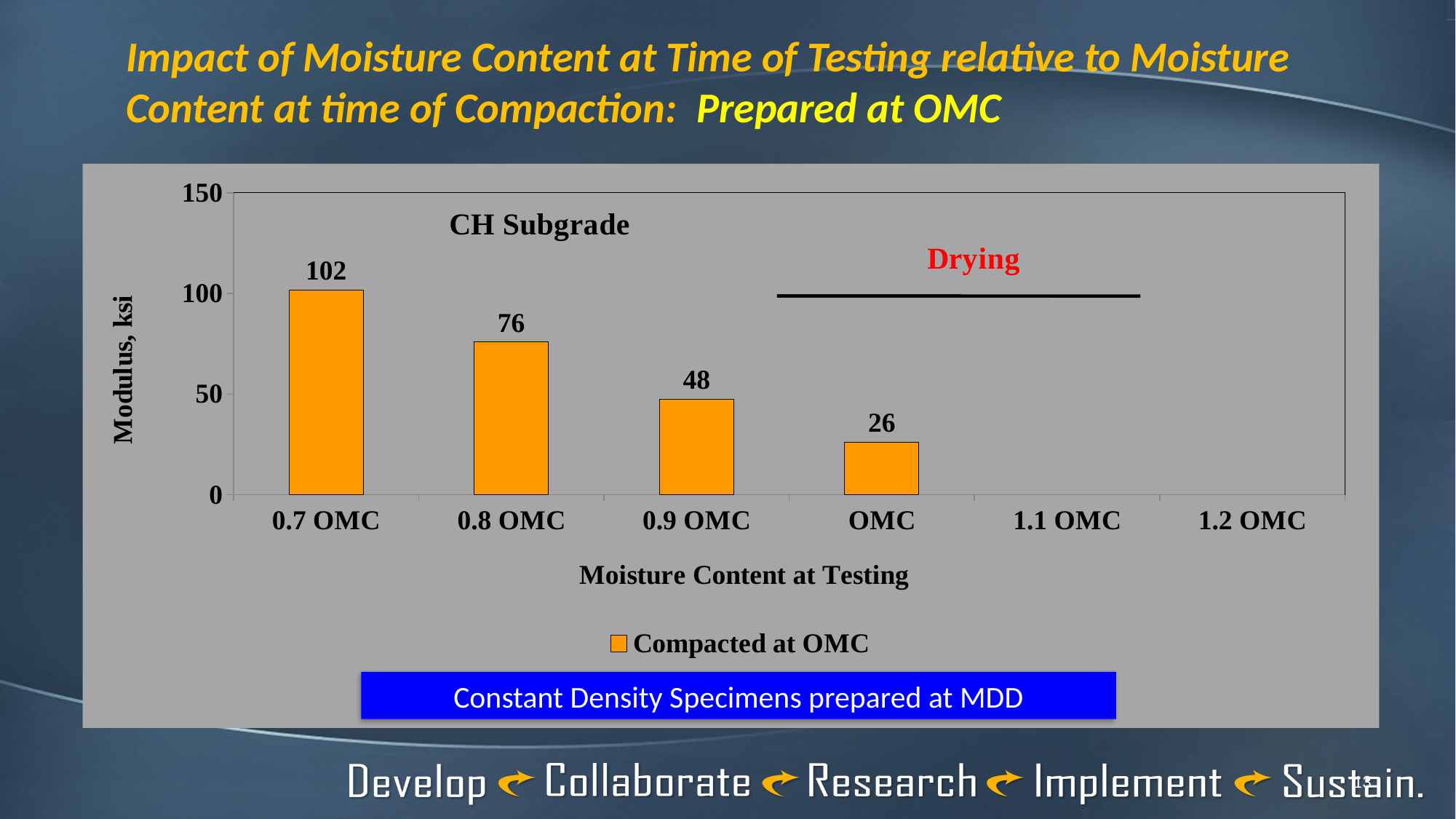
How many series does the legend list? 1 Which moisture content category has the highest modulus? 0.7 OMC Which moisture content category with a plotted bar has the lowest modulus? OMC What is the modulus value for 0.7 OMC? 102 What is the difference between the modulus at 0.7 OMC and at 0.8 OMC? 26 What is the modulus value at OMC? 26 What is the modulus value for 0.9 OMC? 48 How many categories are labelled on the x axis? 6 What kind of chart is shown on the slide? bar chart Is the modulus value for 0.8 OMC greater or less than 50? greater Which is larger, the modulus at 0.8 OMC or at 0.9 OMC? 0.8 OMC Do the modulus values rise or fall as moisture content at testing increases from 0.7 OMC to OMC? fall